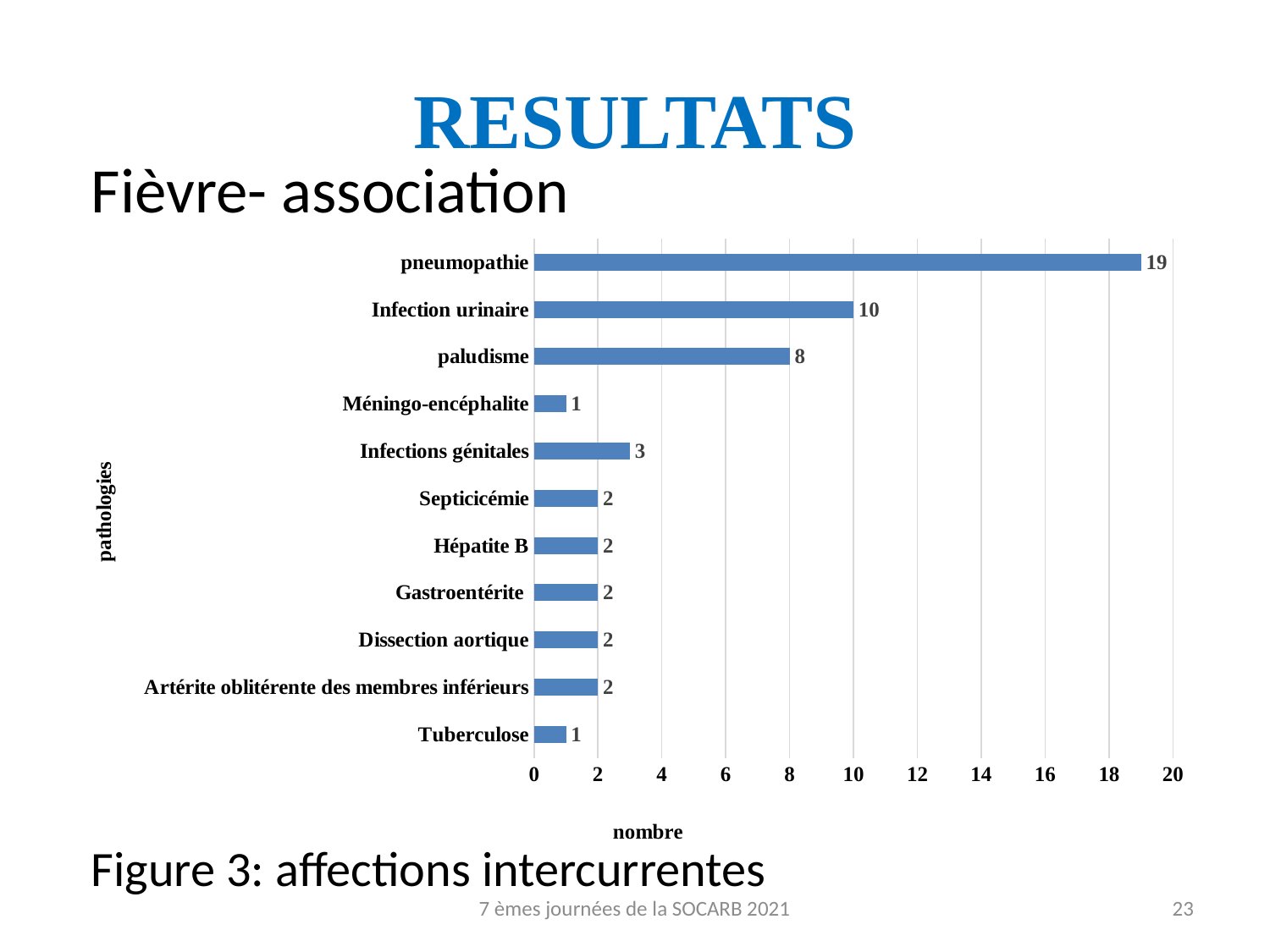
What is the difference between the values for pneumopathie and Infection urinaire? 9 What kind of chart is shown on the slide? bar chart Which pathology has the highest value? pneumopathie What is the value for Infection urinaire? 10 Which is larger, the value for paludisme or the value for Infections génitales? paludisme What is the label of the vertical axis? pathologies What is the value for Infections génitales? 3 What is the value for pneumopathie? 19 What is the label of the horizontal axis? nombre Is the value for Infection urinaire greater or less than 8? greater What is the value for paludisme? 8 How many pathologies are shown in the chart? 11